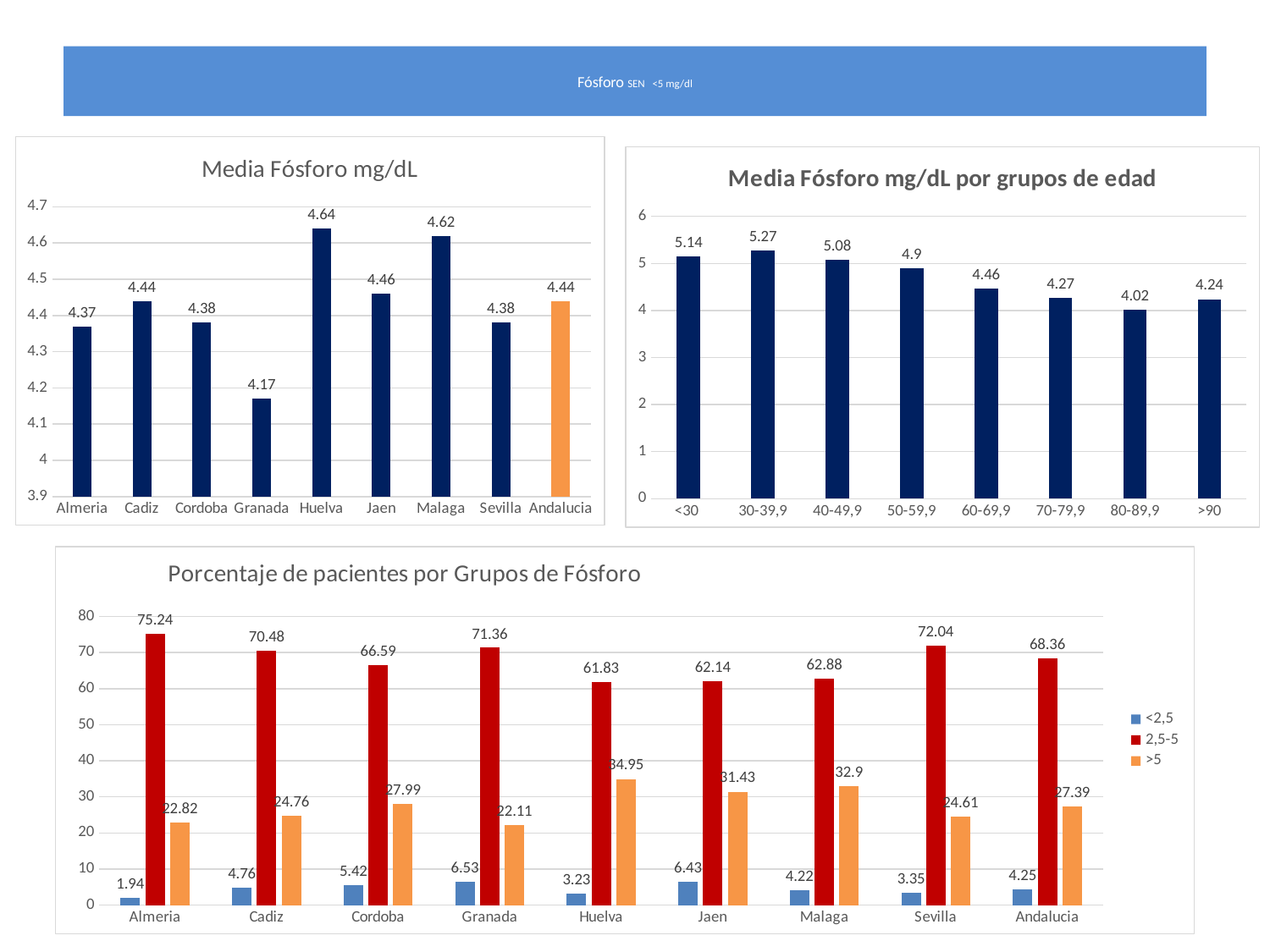
In the chart titled "Media Fósforo mg/dL", what is the difference between the values for Malaga and Granada? 0.45 In the chart titled "Media Fósforo mg/dL", what is the value for Huelva? 4.64 In the chart titled "Porcentaje de pacientes por Grupos de Fósforo", which category has the highest value in the >5 series? Huelva What kind of chart is "Porcentaje de pacientes por Grupos de Fósforo"? bar chart In the chart titled "Media Fósforo mg/dL por grupos de edad", which age group has the lowest value? 80-89,9 In the chart titled "Porcentaje de pacientes por Grupos de Fósforo", how many series does the legend list? 3 In the chart titled "Media Fósforo mg/dL por grupos de edad", what is the value for the 30-39,9 group? 5.27 In the chart titled "Media Fósforo mg/dL por grupos de edad", do the values generally rise or fall from the <30 group to the 80-89,9 group? fall In the chart titled "Porcentaje de pacientes por Grupos de Fósforo", what is the value of the 2,5-5 series for Sevilla? 72.04 In the chart titled "Media Fósforo mg/dL", how many categories are shown on the x axis? 9 In the chart titled "Media Fósforo mg/dL por grupos de edad", is the value for the <30 group greater or less than 5? greater In the chart titled "Media Fósforo mg/dL", which category has the lowest value? Granada